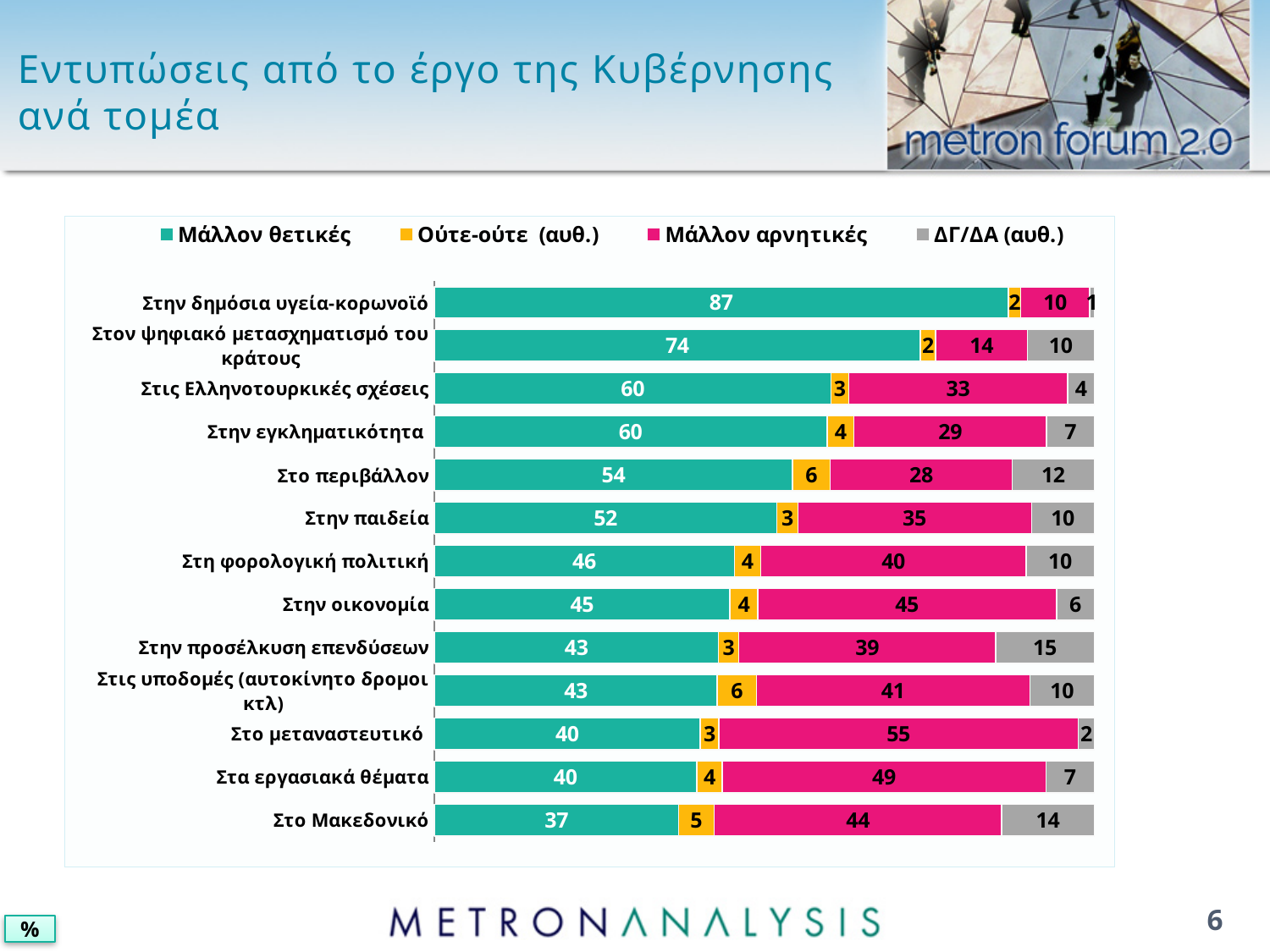
Which category has the highest 'Μάλλον θετικές' value? Στην δημόσια υγεία-κορωνοϊό What is the value of 'Μάλλον θετικές' for 'Στην δημόσια υγεία-κορωνοϊό'? 87 What is the total of the stacked bar for 'Στο περιβάλλον'? 100 How many series does the legend list? 4 How many categories (sectors) are shown in the chart? 13 Which is larger: the 'Μάλλον αρνητικές' value for 'Στα εργασιακά θέματα' or for 'Στο Μακεδονικό'? Στα εργασιακά θέματα What is the value of 'ΔΓ/ΔΑ (αυθ.)' for 'Στην προσέλκυση επενδύσεων'? 15 What is the value of 'Μάλλον αρνητικές' for 'Στο μεταναστευτικό'? 55 What type of chart is shown on the slide? Stacked bar chart What is the difference between the 'Μάλλον θετικές' values for 'Στον ψηφιακό μετασχηματισμό του κράτους' and 'Στην παιδεία'? 22 Which category has the highest 'Μάλλον αρνητικές' value? Στο μεταναστευτικό Which category has the lowest 'Μάλλον θετικές' value? Στο Μακεδονικό